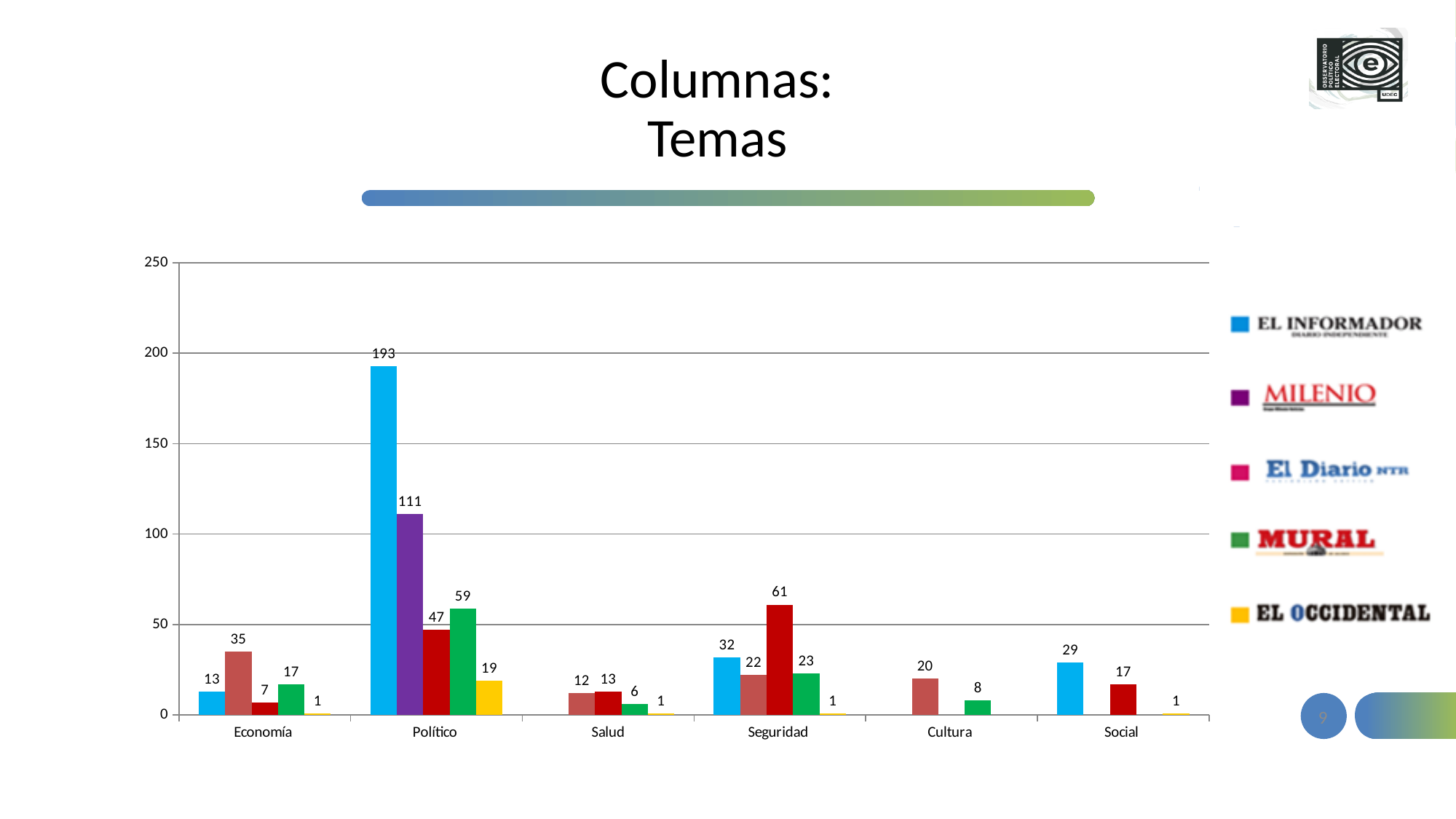
How many newspapers does the legend list? 5 Which category has the tallest bar in the chart? Político What is the value for El Informador (blue bar) in the Político category? 193 What is the difference between El Informador's value in Político and its value in Seguridad? 161 Is the value for El Informador in Político greater or less than 150? greater What is the value for Mural (green bar) in the Cultura category? 8 What is the difference between Mural's value in Político and its value in Economía? 42 What is the value for El Occidental (yellow bar) in the Político category? 19 What is the value for Mural (green bar) in the Político category? 59 What kind of chart is shown on the slide? bar chart Which is larger for Mural (green bar): the value in Economía or the value in Seguridad? Seguridad How many categories are shown on the x axis? 6